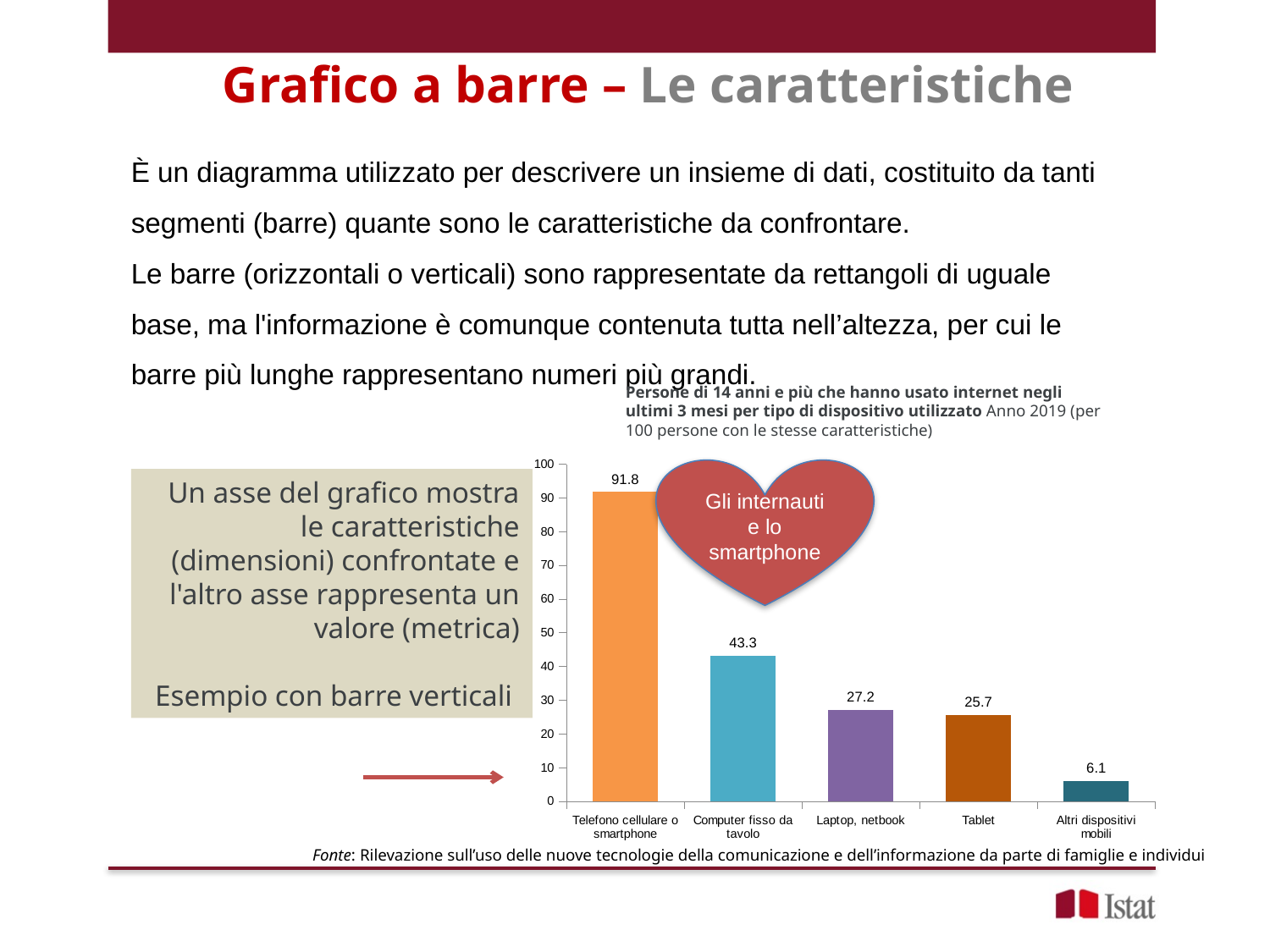
What kind of chart is shown on the slide? Bar chart What is the value for Telefono cellulare o smartphone? 91.8 What is the difference between the values for Laptop, netbook and Tablet? 1.5 What is the value for Computer fisso da tavolo? 43.3 What is the difference between the values for Telefono cellulare o smartphone and Computer fisso da tavolo? 48.5 What is the value for Altri dispositivi mobili? 6.1 Which category has the lowest value? Altri dispositivi mobili Do the values rise or fall from left to right along the x axis? Fall What is the value for Tablet? 25.7 Which category has the highest value? Telefono cellulare o smartphone Which is larger, the value for Computer fisso da tavolo or the value for Laptop, netbook? Computer fisso da tavolo How many categories are shown on the x axis? 5